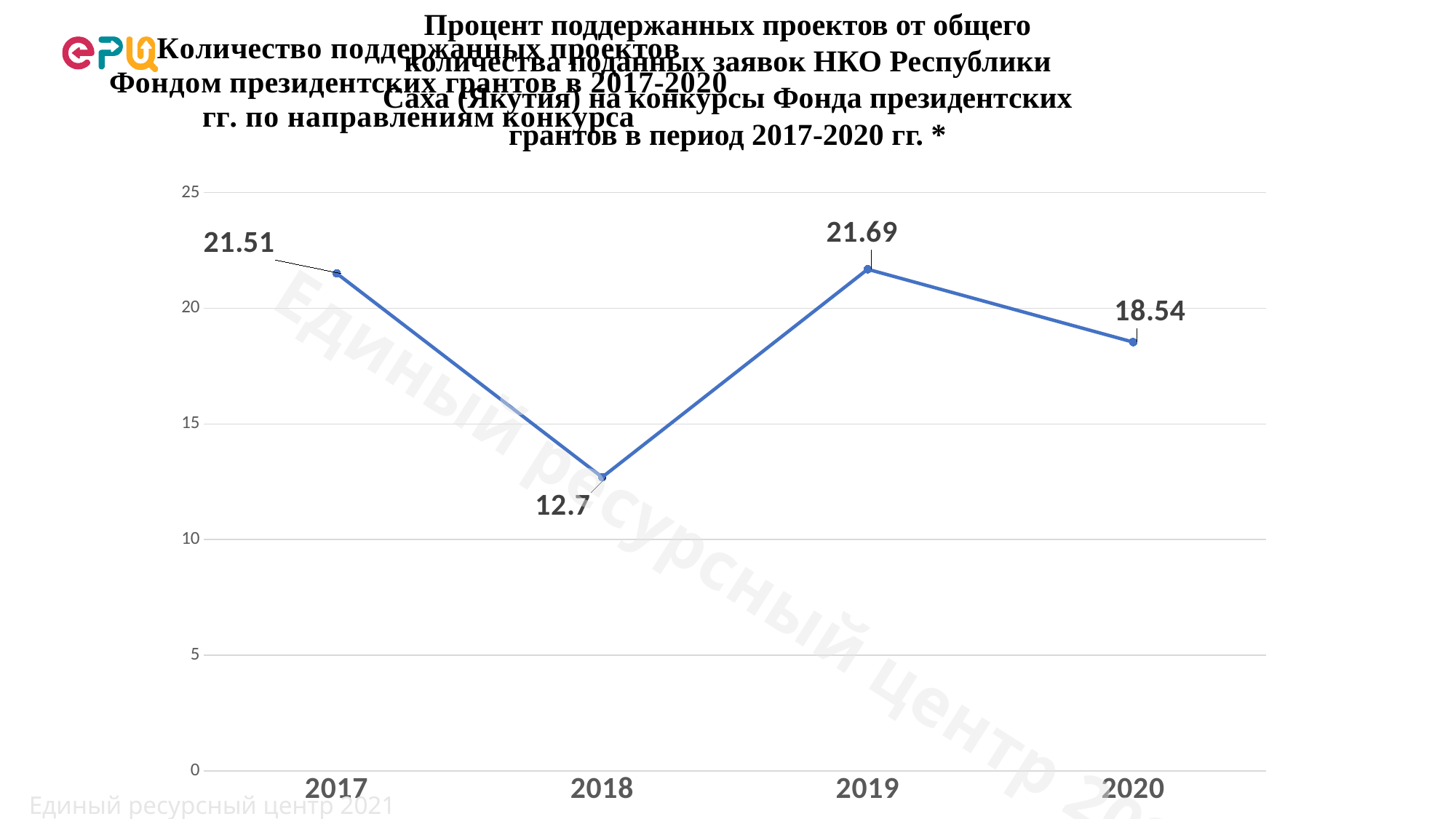
What is the value for 2020? 18.54 Is the value for 2018 greater or less than 15? less What is the difference between the values for 2019 and 2020? 3.15 How many years are plotted on the chart? 4 What is the value for 2018? 12.7 What kind of chart is shown on the slide? line chart Which year has the highest value? 2019 What is the value for 2019? 21.69 What is the value for 2017? 21.51 What is the difference between the values for 2017 and 2018? 8.81 Which year has the lowest value? 2018 Which is larger, the value for 2017 or the value for 2020? 2017